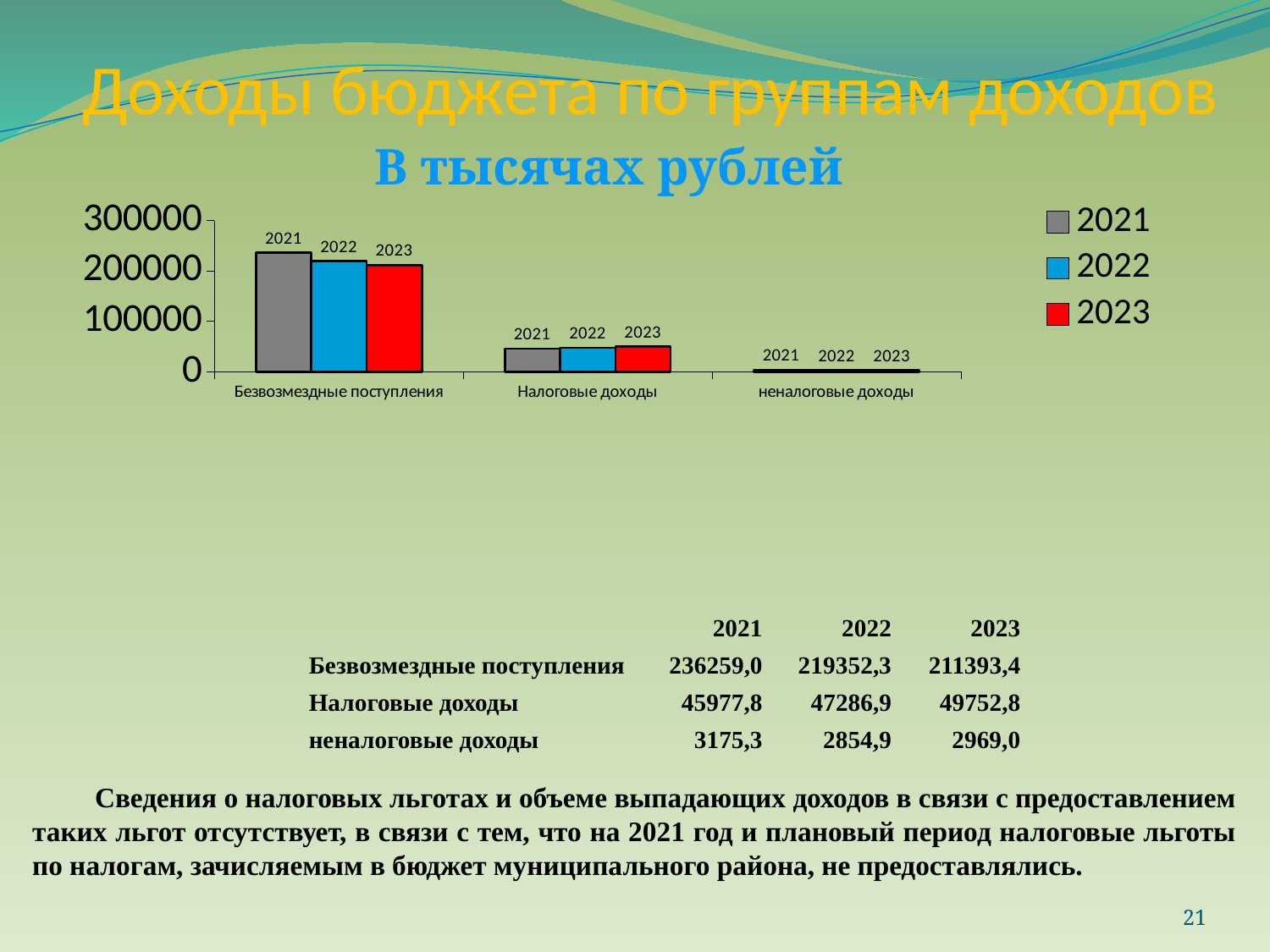
How many series does the chart legend list? 3 Do the values for Безвозмездные поступления rise or fall from 2021 to 2023? fall Which colour represents the 2023 series in the chart? red What kind of chart is shown on the slide? bar chart What is the value for Безвозмездные поступления in 2021? 236259,0 How many categories are shown on the x axis of the chart? 3 Which category has the lowest values in the chart? неналоговые доходы Which category has the highest values in the chart? Безвозмездные поступления What is the value for Налоговые доходы in 2023? 49752,8 What is the value for неналоговые доходы in 2022? 2854,9 Is the value for Безвозмездные поступления in 2021 greater or less than 200000? greater Is the value for Налоговые доходы in 2022 greater or less than 100000? less